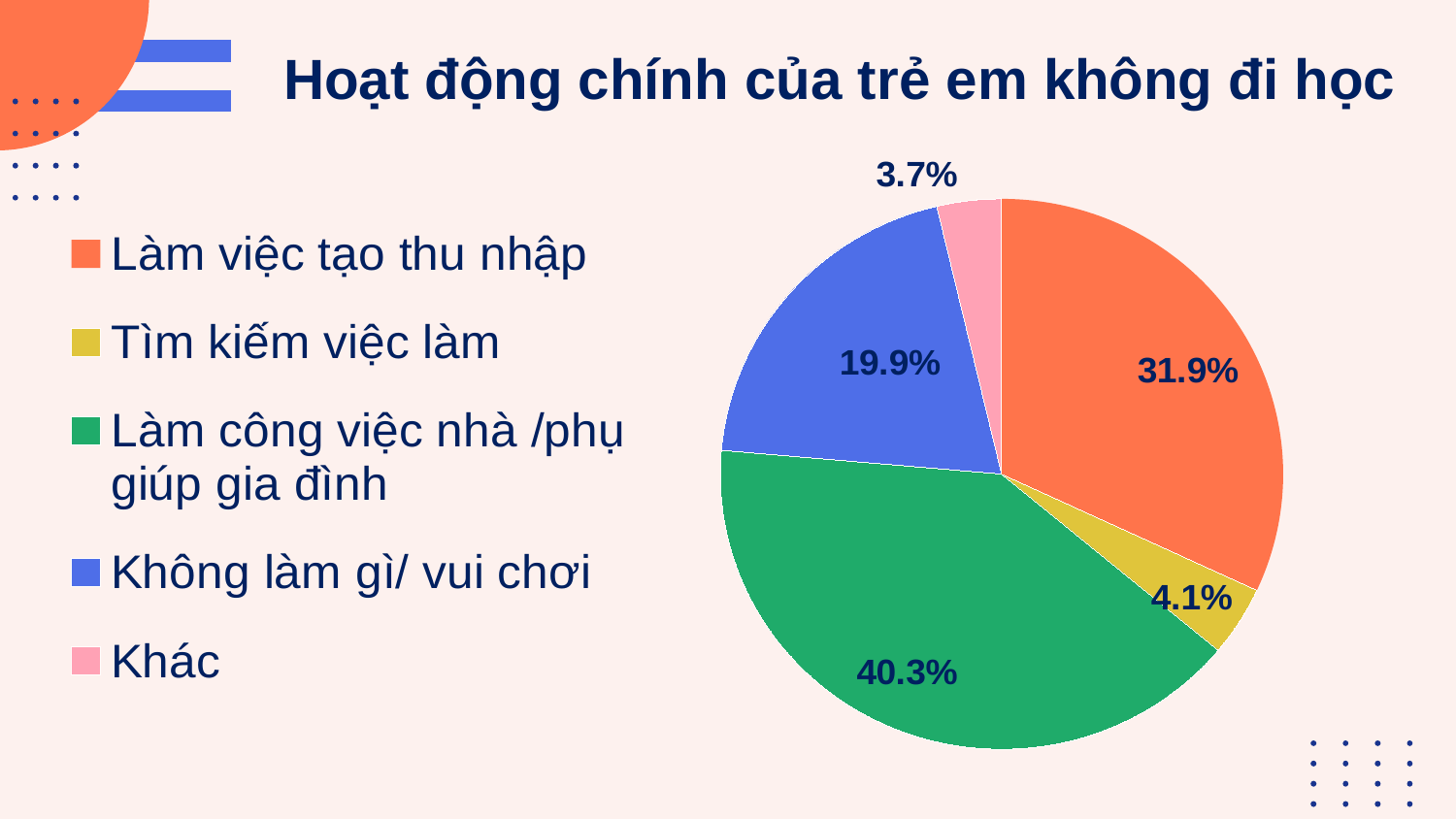
Which category has the largest share of the pie? Làm công việc nhà /phụ giúp gia đình How many categories does the pie chart have? 5 Which category has the smallest share of the pie? Khác What percentage of the pie is 'Làm việc tạo thu nhập'? 31.9% Which is larger: the share for 'Không làm gì/ vui chơi' or the share for 'Tìm kiếm việc làm'? Không làm gì/ vui chơi What is the title of the chart? Hoạt động chính của trẻ em không đi học What percentage of the pie is 'Khác'? 3.7% What percentage of the pie is 'Không làm gì/ vui chơi'? 19.9% What is the difference in percentage points between 'Làm công việc nhà /phụ giúp gia đình' and 'Làm việc tạo thu nhập'? 8.4 What percentage of the pie is 'Tìm kiếm việc làm'? 4.1% What percentage of the pie is 'Làm công việc nhà /phụ giúp gia đình'? 40.3% What type of chart is shown on the slide? pie chart